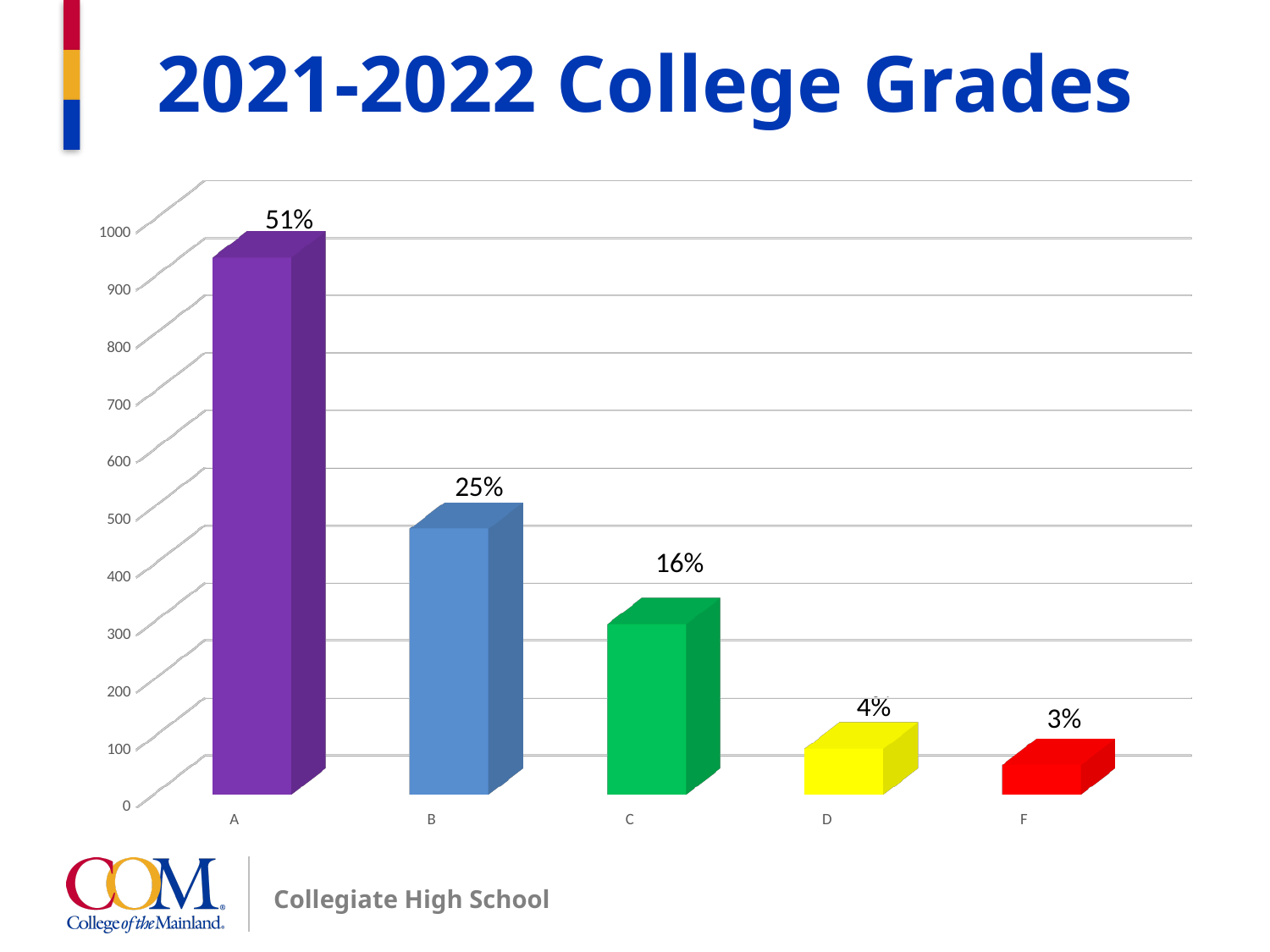
How many grade categories are shown on the x axis? 5 What is the data label shown for grade F? 3% What is the difference in percentage points between the labels for grade A and grade B? 26% What is the data label shown for grade B? 25% What is the data label shown for grade A? 51% What is the title of the chart? 2021-2022 College Grades Which is larger, the value for grade C or the value for grade D? C What kind of chart is shown on the slide? Bar chart Which grade has the highest bar? A What is the data label shown for grade C? 16% Which grade has the lowest bar? F Is the value for grade B greater or less than 400? greater